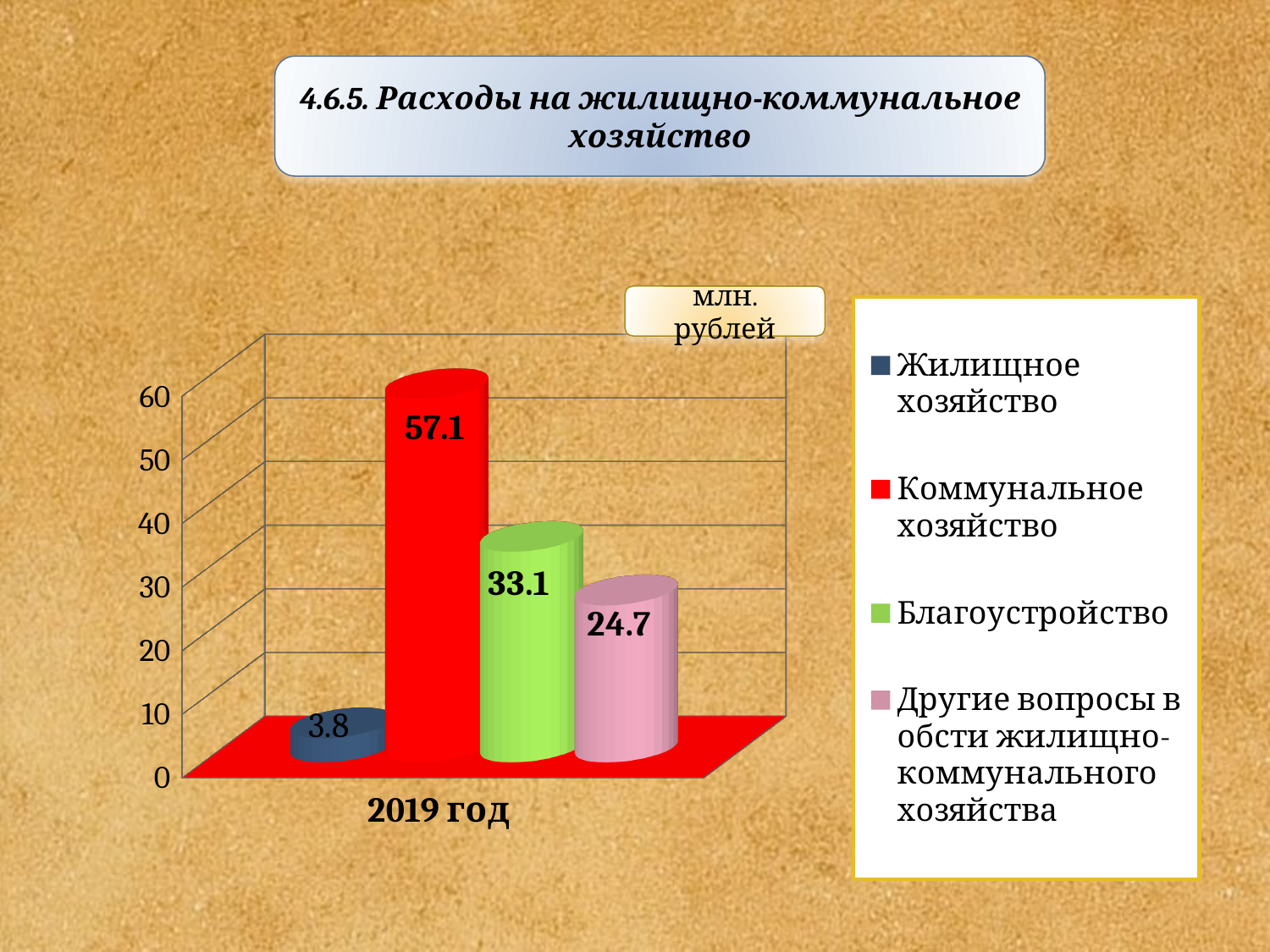
What is the value for Благоустройство in 2019 год? 33.1 Which is larger, the value for Благоустройство or the value for Другие вопросы в обсти жилищно-коммунального хозяйства? Благоустройство What kind of chart is shown on the slide? Bar chart What colour is the bar for Коммунальное хозяйство? Red What is the value for Другие вопросы в обсти жилищно-коммунального хозяйства in 2019 год? 24.7 How many series does the legend list? 4 Which series has the highest value in 2019 год? Коммунальное хозяйство What is the value for Жилищное хозяйство in 2019 год? 3.8 Which series has the lowest value in 2019 год? Жилищное хозяйство What unit is indicated for the values on the chart? млн. рублей What is the value for Коммунальное хозяйство in 2019 год? 57.1 What is the difference between the values for Коммунальное хозяйство and Благоустройство? 24